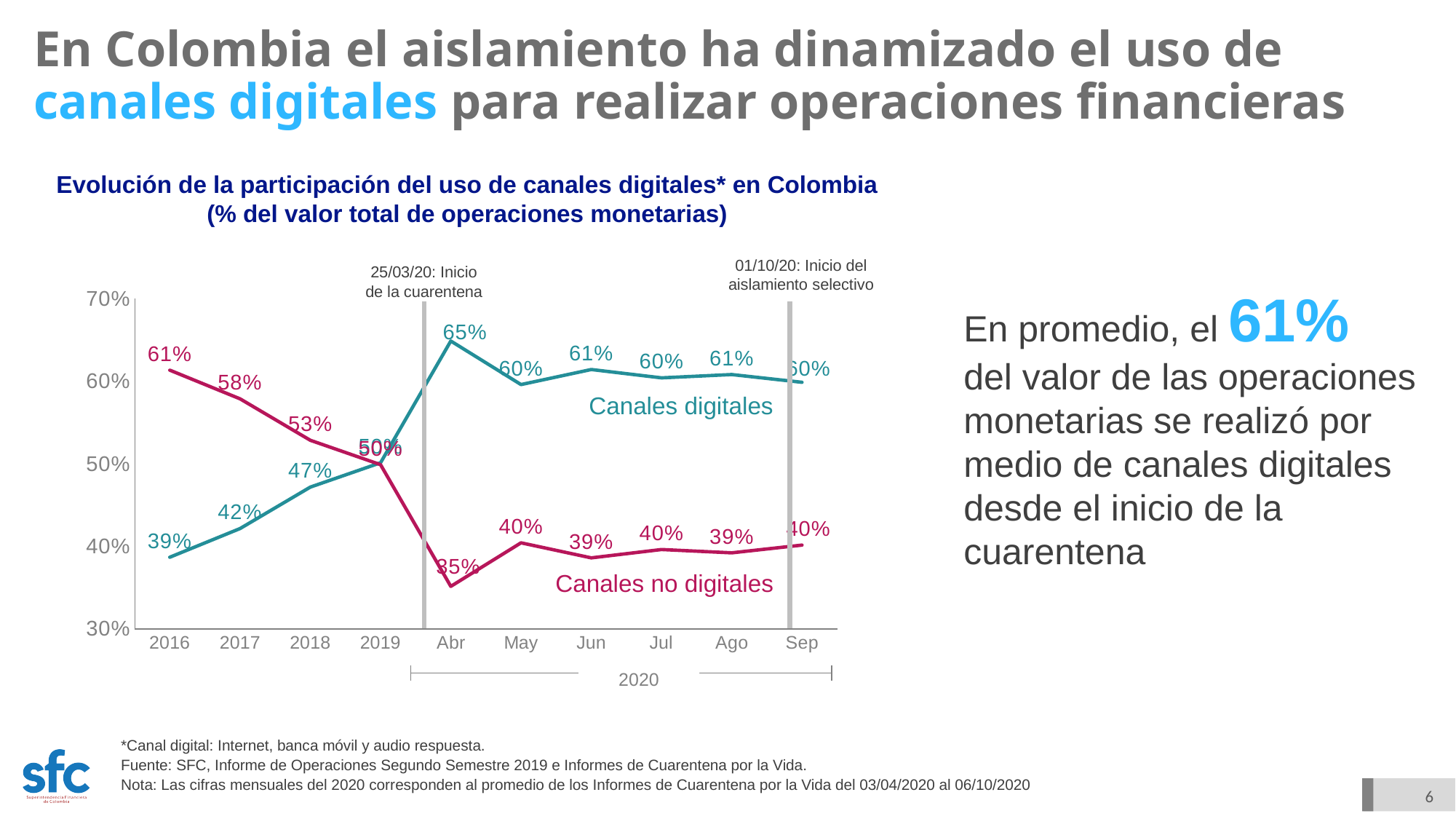
What is the difference between Canales digitales and Canales no digitales in Abr 2020? 30% In which period does Canales digitales reach its highest value? Abr Which series has the larger value in 2018, Canales digitales or Canales no digitales? Canales no digitales What is the title of the chart? Evolución de la participación del uso de canales digitales* en Colombia (% del valor total de operaciones monetarias) What type of chart is shown on the slide? line chart What is the value for Canales digitales in Abr 2020? 65% How does the Canales digitales series change from 2016 to 2019? It rises What is the value for Canales no digitales in Abr 2020? 35% In which period does Canales no digitales reach its lowest value? Abr What is the value for Canales no digitales in 2017? 58% What is the value for Canales digitales in 2016? 39% How many time points are plotted on the x axis? 10